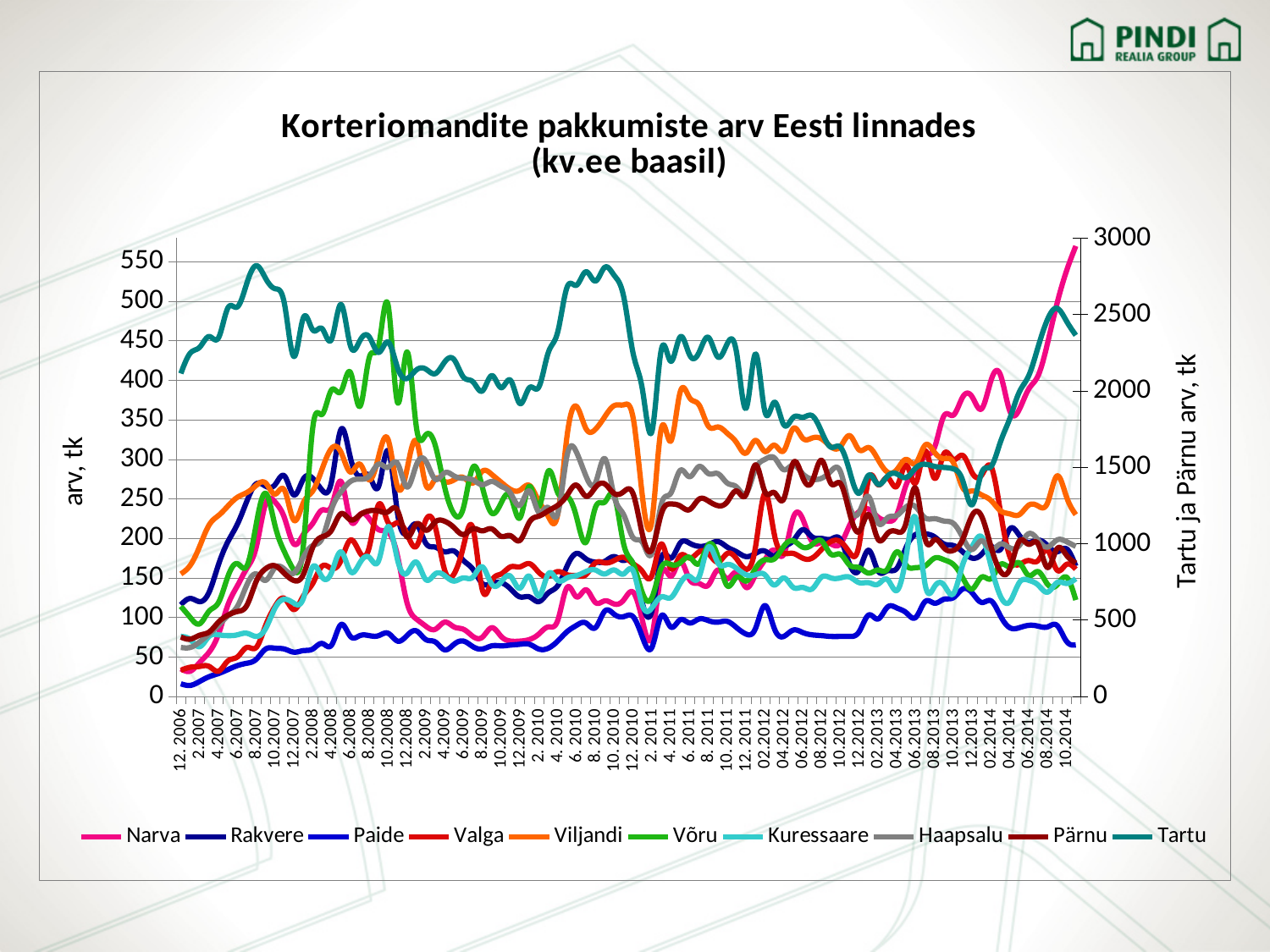
What is the title of the chart? Korteriomandite pakkumiste arv Eesti linnades (kv.ee baasil) What is the label of the right-hand vertical axis? Tartu ja Pärnu arv, tk Is the value for Paide at 10.2014 greater or less than 100? less Does the Narva line rise or fall between 02.2013 and 10.2014? rise Is the value for Tartu at 12.2006 (right axis) greater or less than 2000? greater What kind of chart is shown on the slide? line chart Is the value for Tartu at 2.2011 (right axis) greater or less than 2000? less Among the series plotted on the left axis, which reaches the highest value anywhere on the chart? Narva How many series does the legend list? 10 Among the series plotted on the left axis, which has the lowest value at 10.2014? Paide